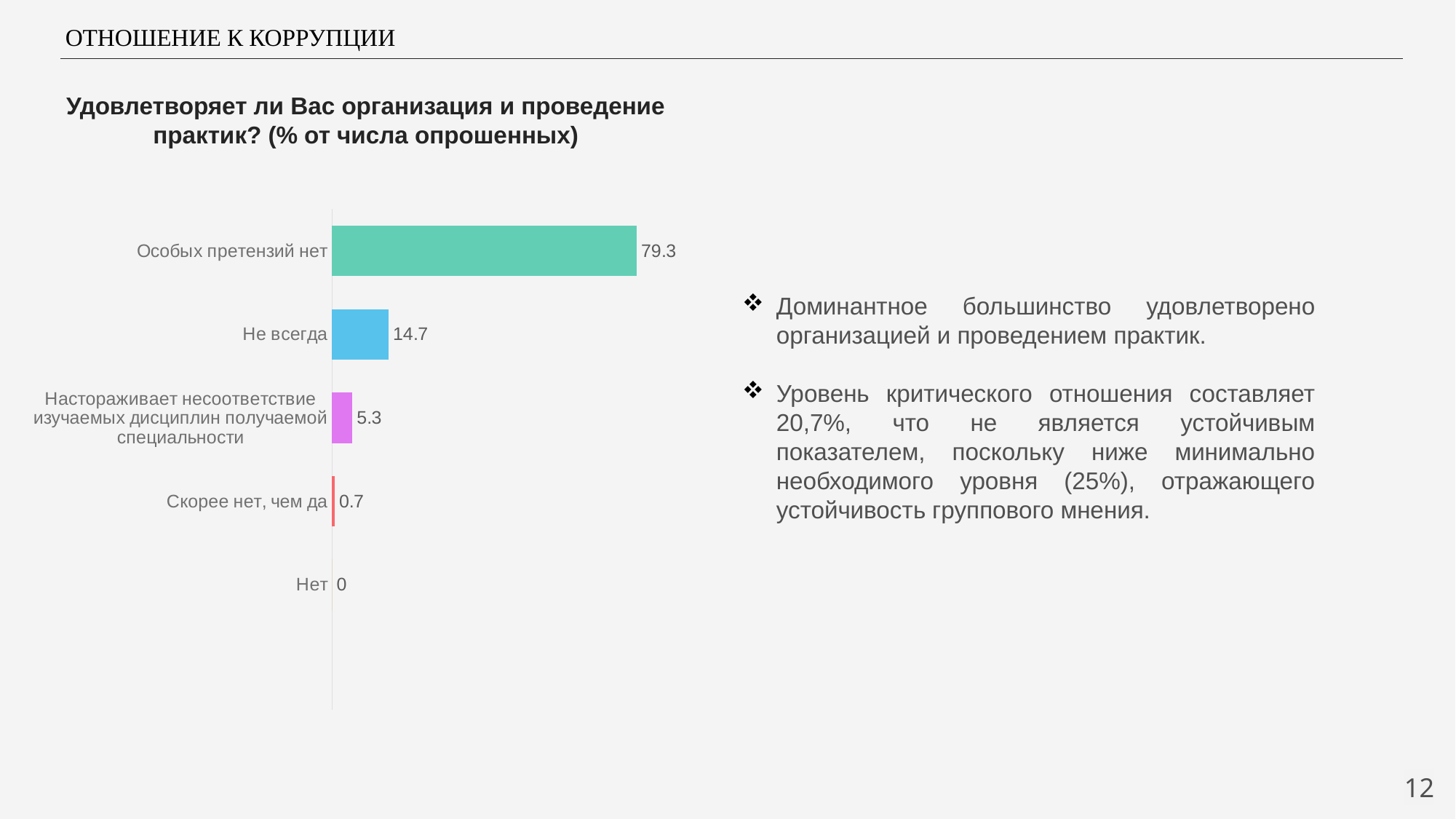
How many categories are shown in the chart? 5 Which category has the highest value? Особых претензий нет What is the value for "Не всегда"? 14.7 What is the value for "Особых претензий нет"? 79.3 What is the difference between the values for "Особых претензий нет" and "Не всегда"? 64.6 What is the value for "Нет"? 0 Which category has the lowest value? Нет Which is larger: the value for "Не всегда" or the value for "Скорее нет, чем да"? Не всегда What kind of chart is shown on the slide? Bar chart What is the title of the chart? Удовлетворяет ли Вас организация и проведение практик? (% от числа опрошенных) What is the value for "Скорее нет, чем да"? 0.7 What is the value for "Настораживает несоответствие изучаемых дисциплин получаемой специальности"? 5.3